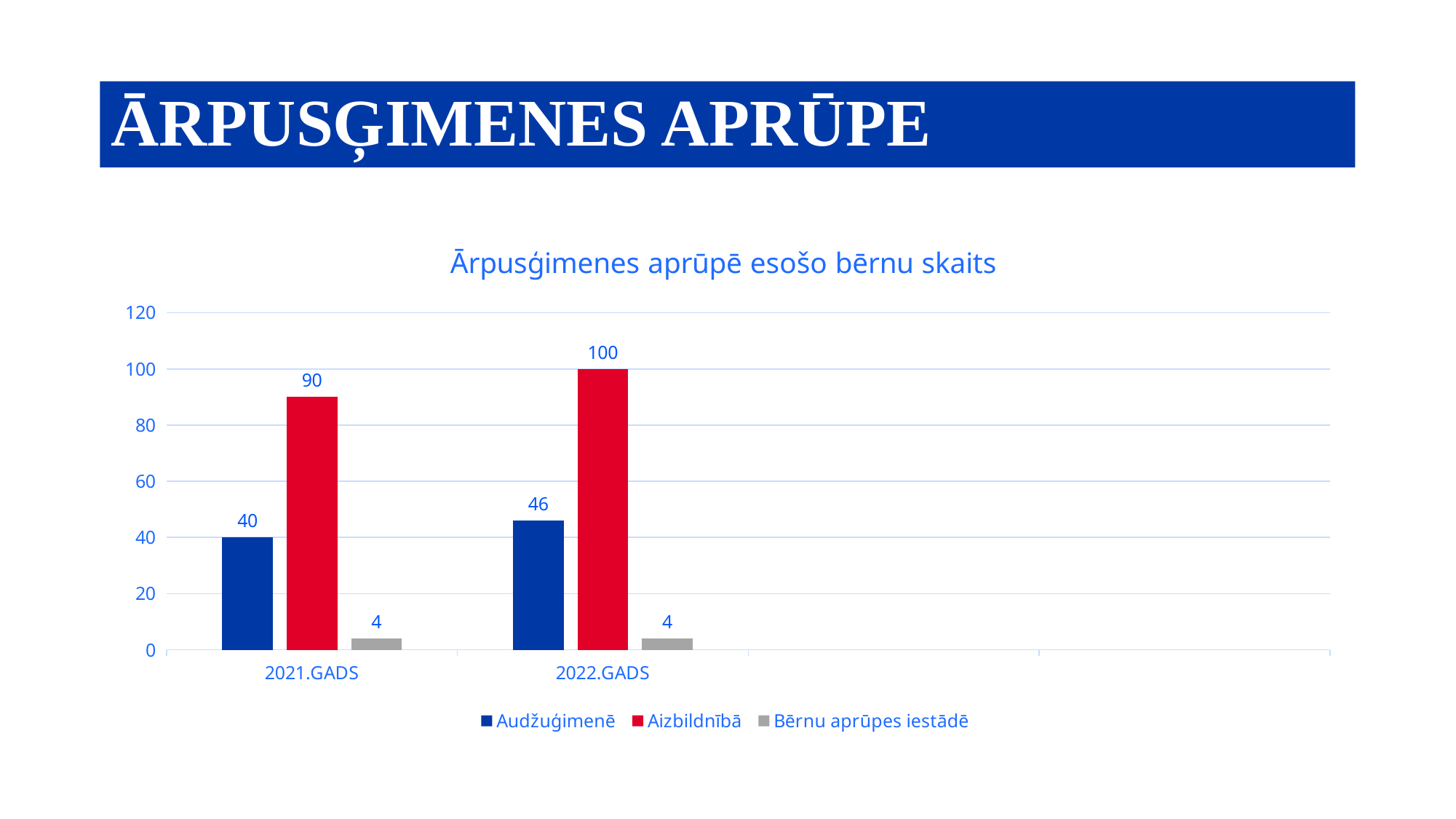
Which is larger, Audžuģimenē in 2021.GADS or Audžuģimenē in 2022.GADS? Audžuģimenē in 2022.GADS How many series does the legend list? 3 What is the title of the chart? Ārpusģimenes aprūpē esošo bērnu skaits What is the value for Aizbildnībā in 2021.GADS? 90 Which series has the highest value in 2022.GADS? Aizbildnībā Which series has the lowest value in 2021.GADS? Bērnu aprūpes iestādē What is the value for Audžuģimenē in 2022.GADS? 46 What is the difference between the Aizbildnībā values for 2022.GADS and 2021.GADS? 10 What is the difference between Aizbildnībā and Audžuģimenē in 2021.GADS? 50 What kind of chart is shown on the slide? Bar chart What is the value for Bērnu aprūpes iestādē in 2021.GADS? 4 How many categories are shown on the x axis? 2